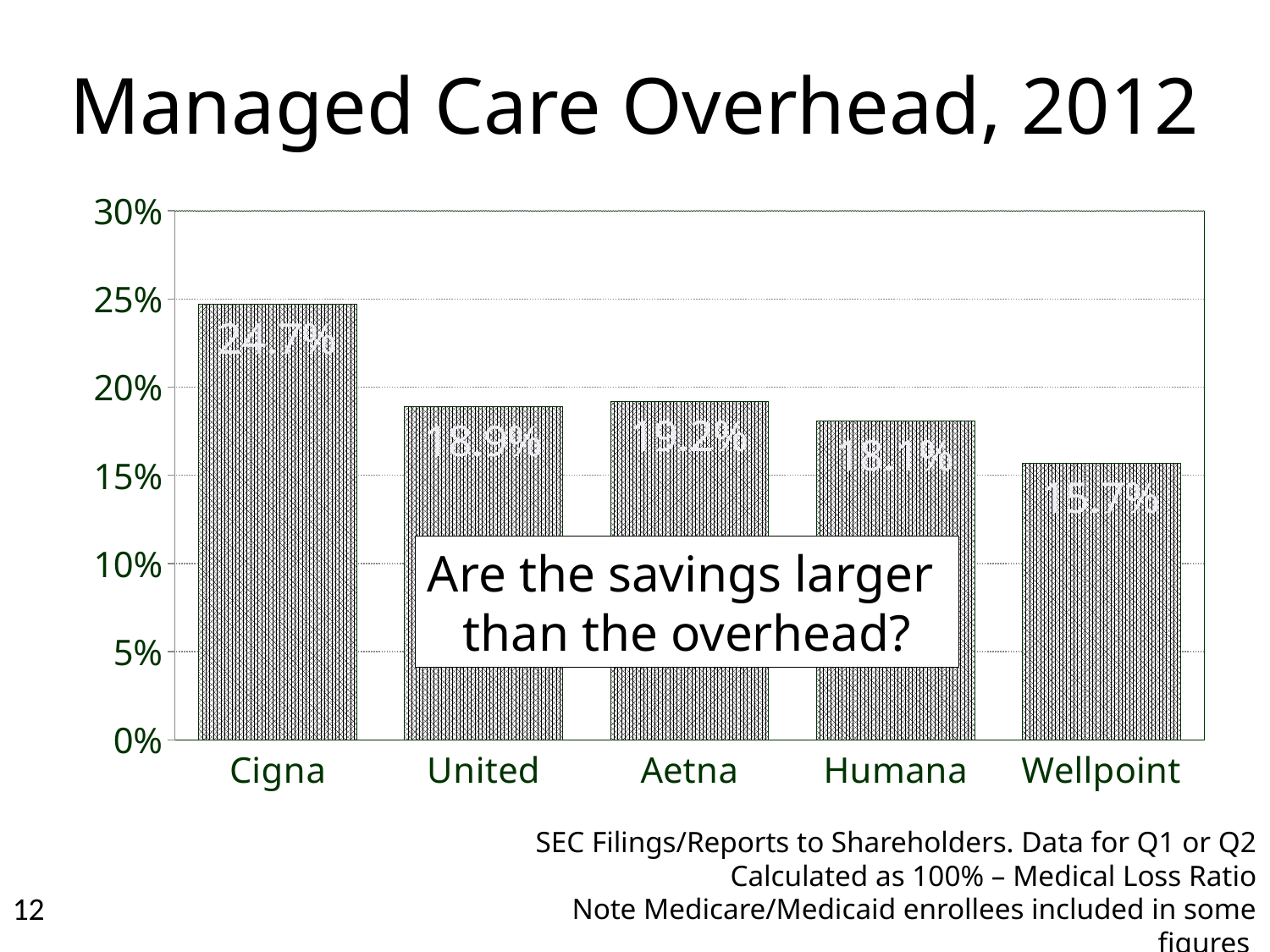
Which has a larger overhead, Cigna or Aetna? Cigna What is the overhead value shown for Cigna? 24.7% What is the title of the slide containing the chart? Managed Care Overhead, 2012 What kind of chart is shown on the slide? bar chart Which company has the highest overhead in the chart? Cigna How many companies are shown in the chart? 5 What is the overhead value shown for Humana? 18.1% What is the difference between Cigna's overhead and Wellpoint's overhead? 9.0% Which company has the lowest overhead in the chart? Wellpoint Is the value for Wellpoint greater or less than 20%? less What is the overhead value shown for Wellpoint? 15.7% What is the difference between Aetna's overhead and United's overhead? 0.3%